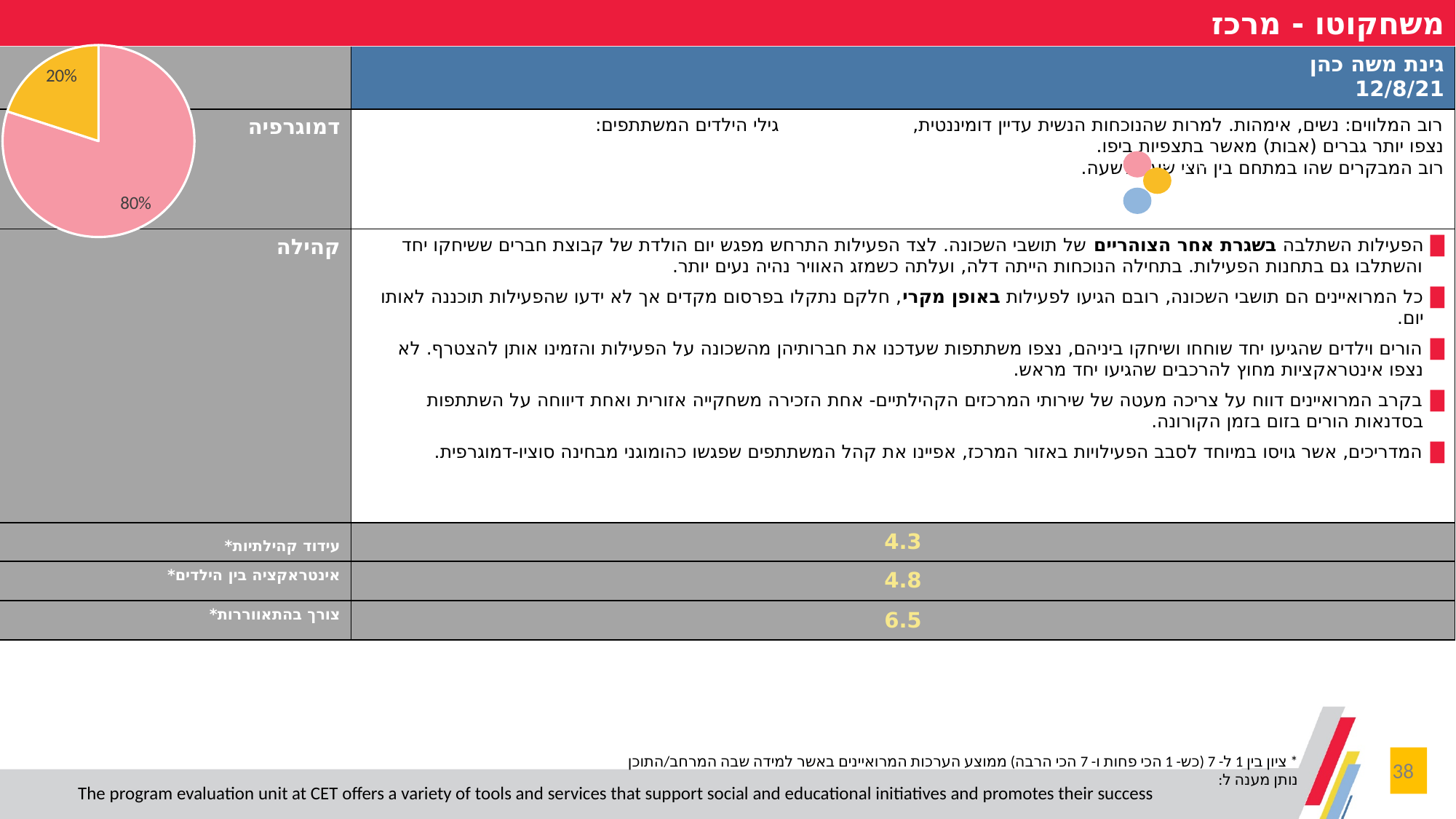
What kind of chart is shown in the top-left corner of the slide? pie chart On the pie chart in the top-left corner, which slice is larger, the pink one or the yellow one? pink What colour is the largest slice of the pie chart in the top-left corner? pink Does the pie chart in the top-left corner have a title? No On the pie chart in the top-left corner, what percentage is labelled on the yellow slice? 20% On the pie chart in the top-left corner, what percentage is labelled on the pink slice? 80% What share of the pie chart in the top-left corner does the yellow slice represent? 20% How many slices does the pie chart in the top-left corner have? 2 What is the smallest value shown on the pie chart in the top-left corner? 20% What is the largest value shown on the pie chart in the top-left corner? 80% On the pie chart in the top-left corner, what is the difference between the two slice values? 60%